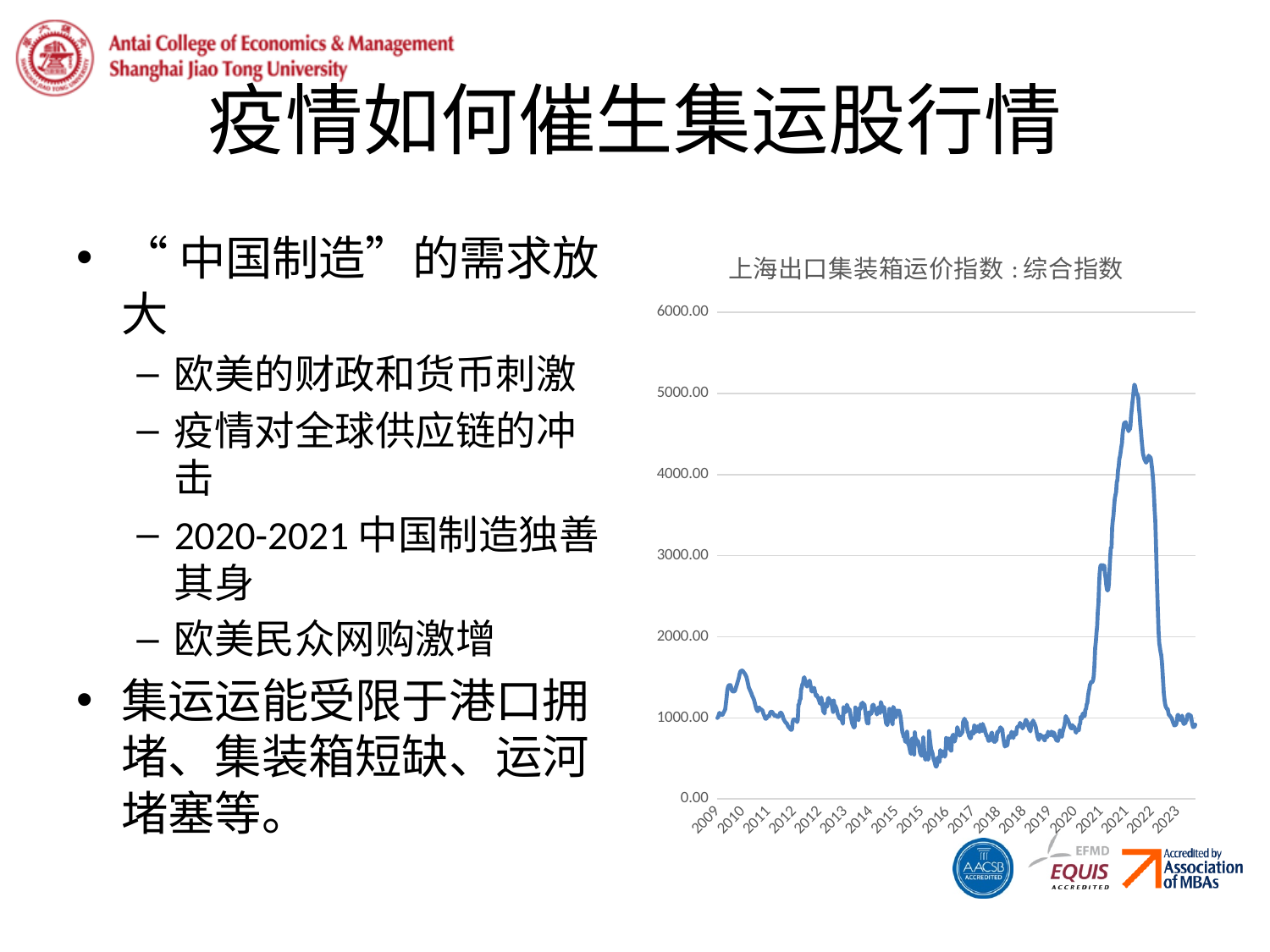
What is the first year shown on the chart's horizontal axis? 2009 Is the peak value of the index on the chart greater or less than 6000? less What is the title of the chart on the slide? 上海出口集装箱运价指数：综合指数 Does the index rise or fall between 2022 and 2023? fall What is the highest value shown on the chart's vertical axis? 6000.00 Which is larger: the index value around 2021 or the index value around 2019? 2021 Is the peak value of the index on the chart greater or less than 4000? greater Is the value of the index at the end of the series in 2023 greater or less than 2000? less Does the index rise or fall between 2020 and 2021? rise What kind of chart is shown on the slide? line chart